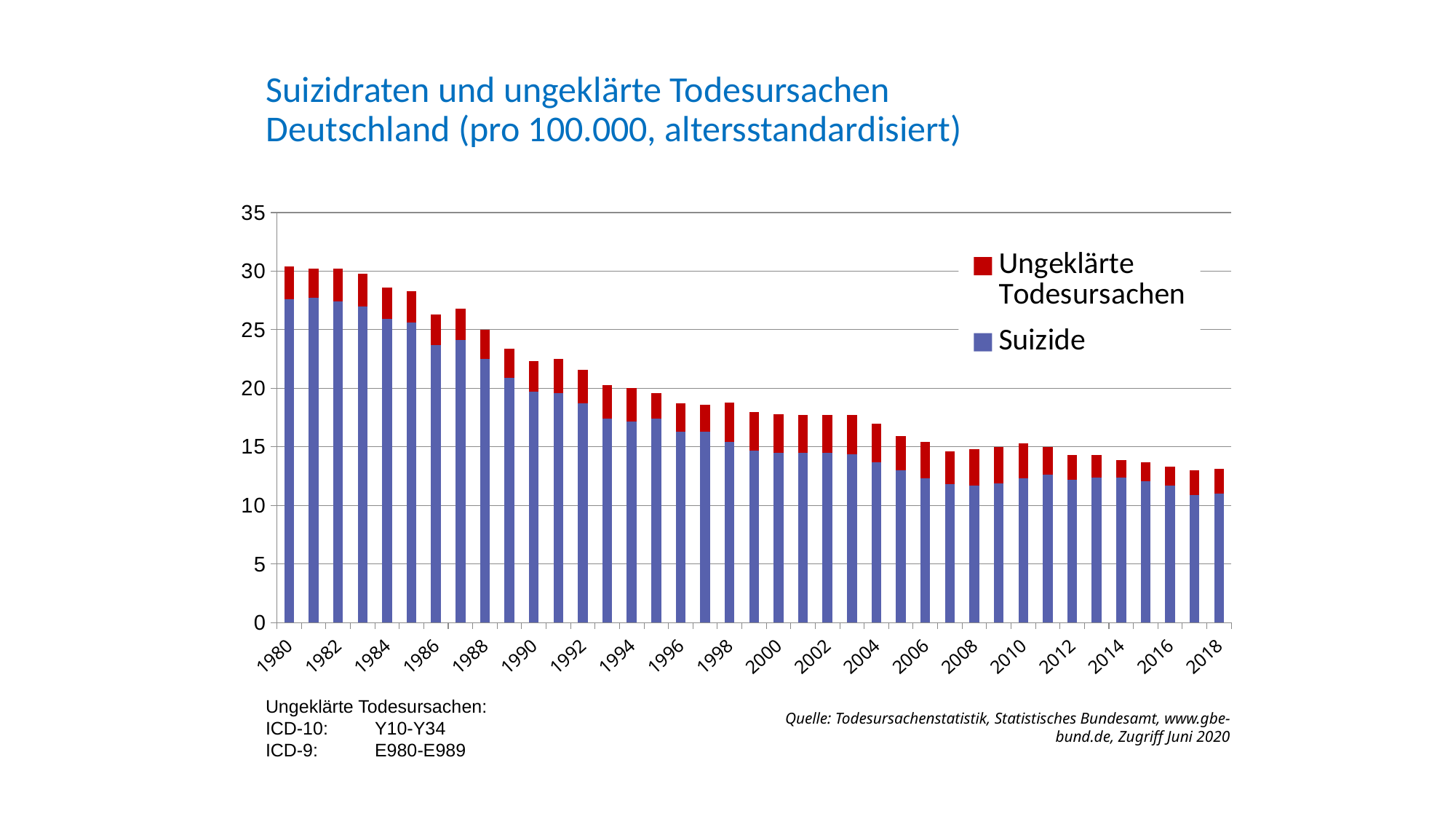
Which year has the highest total bar? 1980 Which series is shown in red in the legend? Ungeklärte Todesursachen What kind of chart is shown on the slide? Stacked bar chart Is the total value for 1990 greater or less than 20? greater Is the Suizide value for 2010 greater or less than 10? greater Do the total values rise or fall from 1980 to 2018? Fall Is the total value for 2018 greater or less than 15? less What is the title of the chart? Suizidraten und ungeklärte Todesursachen Deutschland (pro 100.000, altersstandardisiert) Is the total bar for 1980 larger or smaller than the total bar for 2018? Larger How many series does the legend list? 2 How many years (bars) are plotted on the x axis? 39